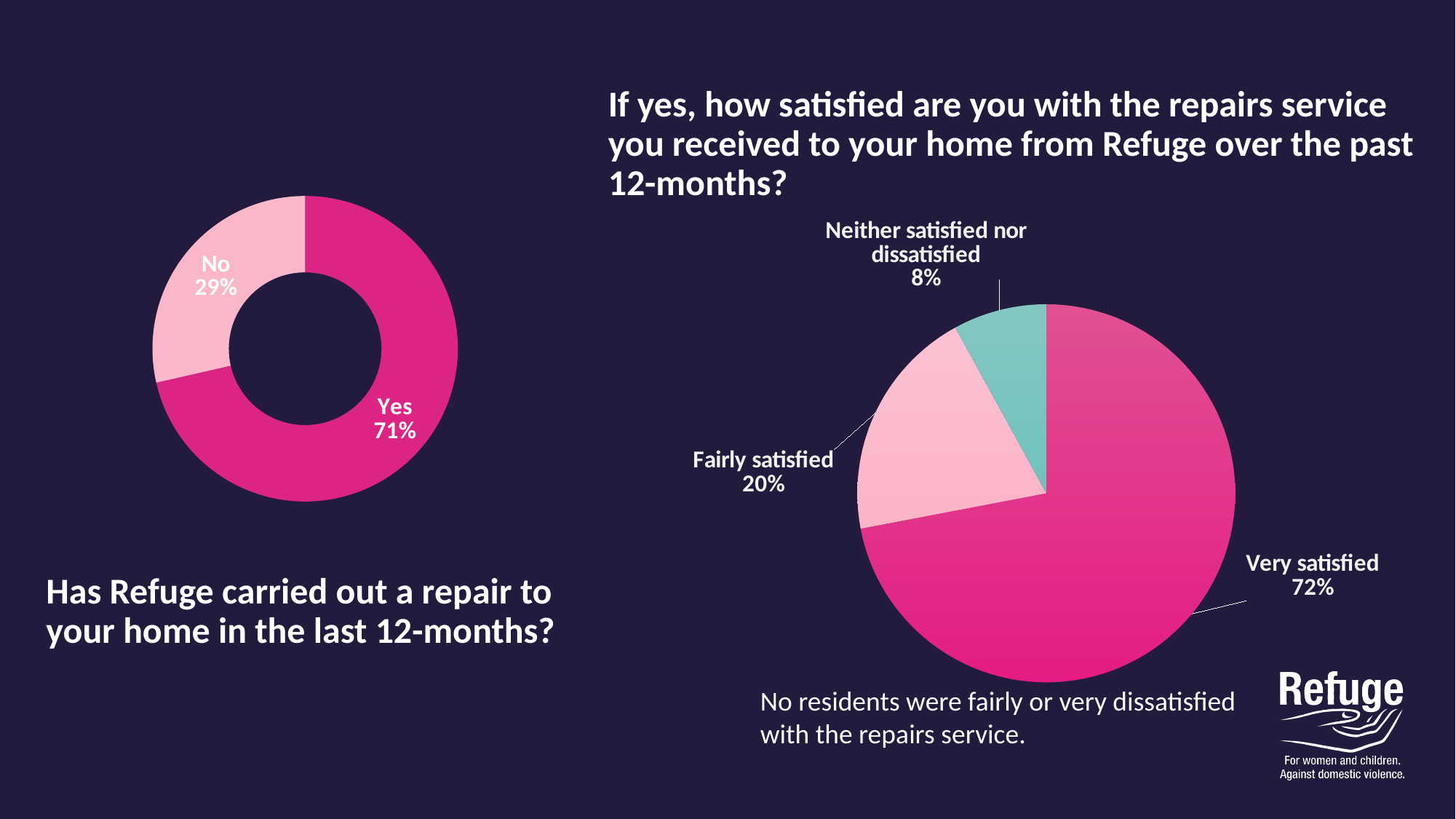
In the chart 'If yes, how satisfied are you with the repairs service...', what percentage were Fairly satisfied? 20% What kind of chart is the one on the right of the slide? Pie chart In the chart 'Has Refuge carried out a repair to your home in the last 12-months?', what percentage answered No? 29% In the chart 'If yes, how satisfied are you with the repairs service...', what percentage were Very satisfied? 72% In the chart 'If yes, how satisfied are you with the repairs service...', what is the difference between Very satisfied and Fairly satisfied? 52% In the chart 'Has Refuge carried out a repair to your home in the last 12-months?', what is the difference between the Yes and No shares? 42% In the chart 'If yes, how satisfied are you with the repairs service...', which category has the smallest share? Neither satisfied nor dissatisfied What kind of chart is the one on the left of the slide? Doughnut chart In the chart 'Has Refuge carried out a repair to your home in the last 12-months?', which answer has the larger share? Yes In the chart 'Has Refuge carried out a repair to your home in the last 12-months?', what percentage answered Yes? 71% In the chart 'If yes, how satisfied are you with the repairs service...', how many categories are shown? 3 In the chart 'If yes, how satisfied are you with the repairs service...', what percentage were Neither satisfied nor dissatisfied? 8%